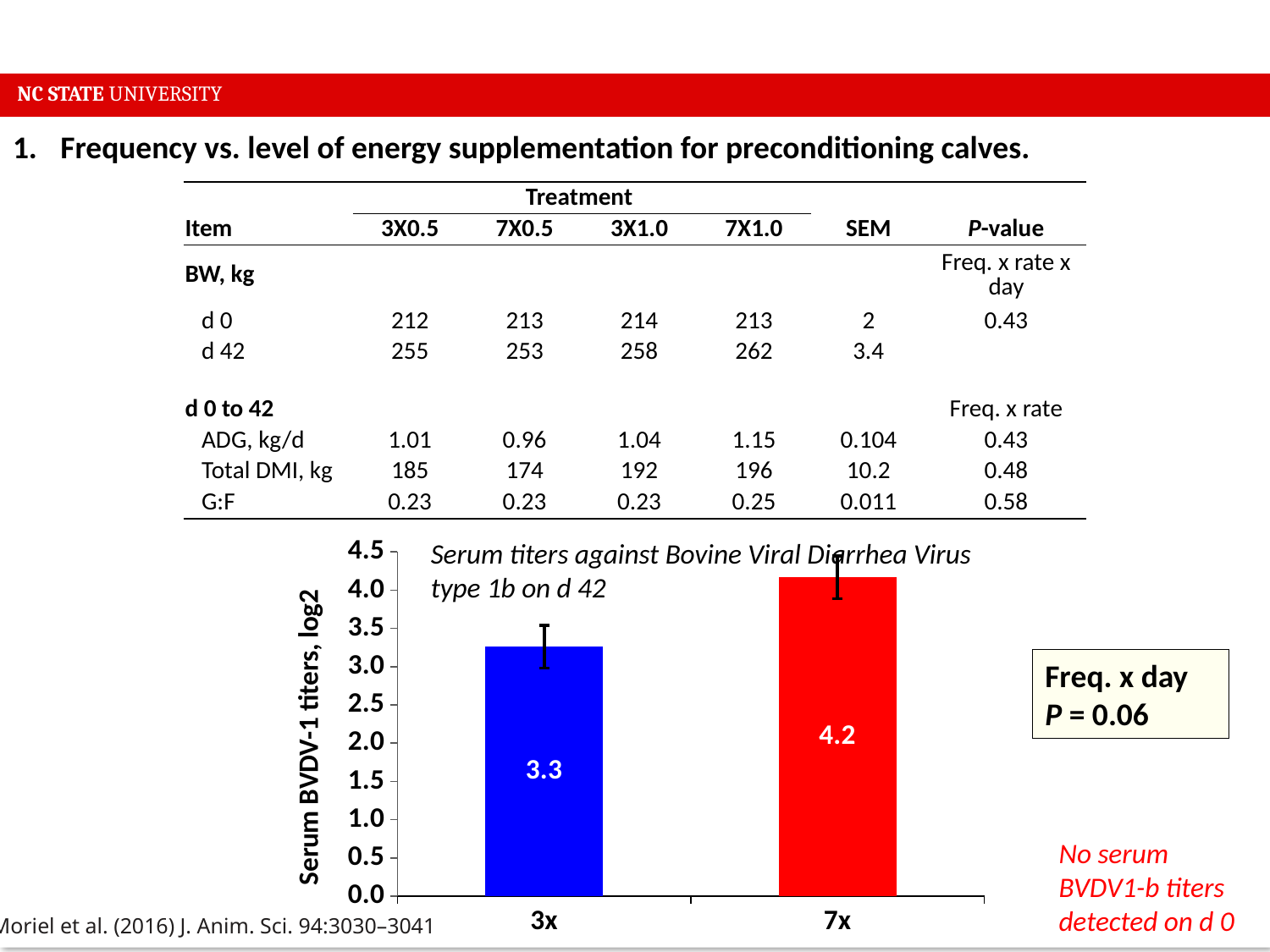
Do the serum BVDV-1 titer values rise or fall from 3x to 7x? Rise How many bars are plotted in the bar chart? 2 Is the value for 3x greater or less than 3.0 on the y axis? greater What is the label of the y axis of the bar chart? Serum BVDV-1 titers, log2 Which category has the higher serum BVDV-1 titer, 3x or 7x? 7x What is the serum BVDV-1 titer value shown for the 3x bar? 3.3 What is the serum BVDV-1 titer value shown for the 7x bar? 4.2 Is the value for 7x greater or less than 4.5 on the y axis? less What kind of chart is shown at the bottom of the slide? Bar chart What is the difference between the 7x and 3x serum BVDV-1 titer values? 0.9 Which category has the lowest serum BVDV-1 titer in the bar chart? 3x What colour is the 7x bar in the chart? Red